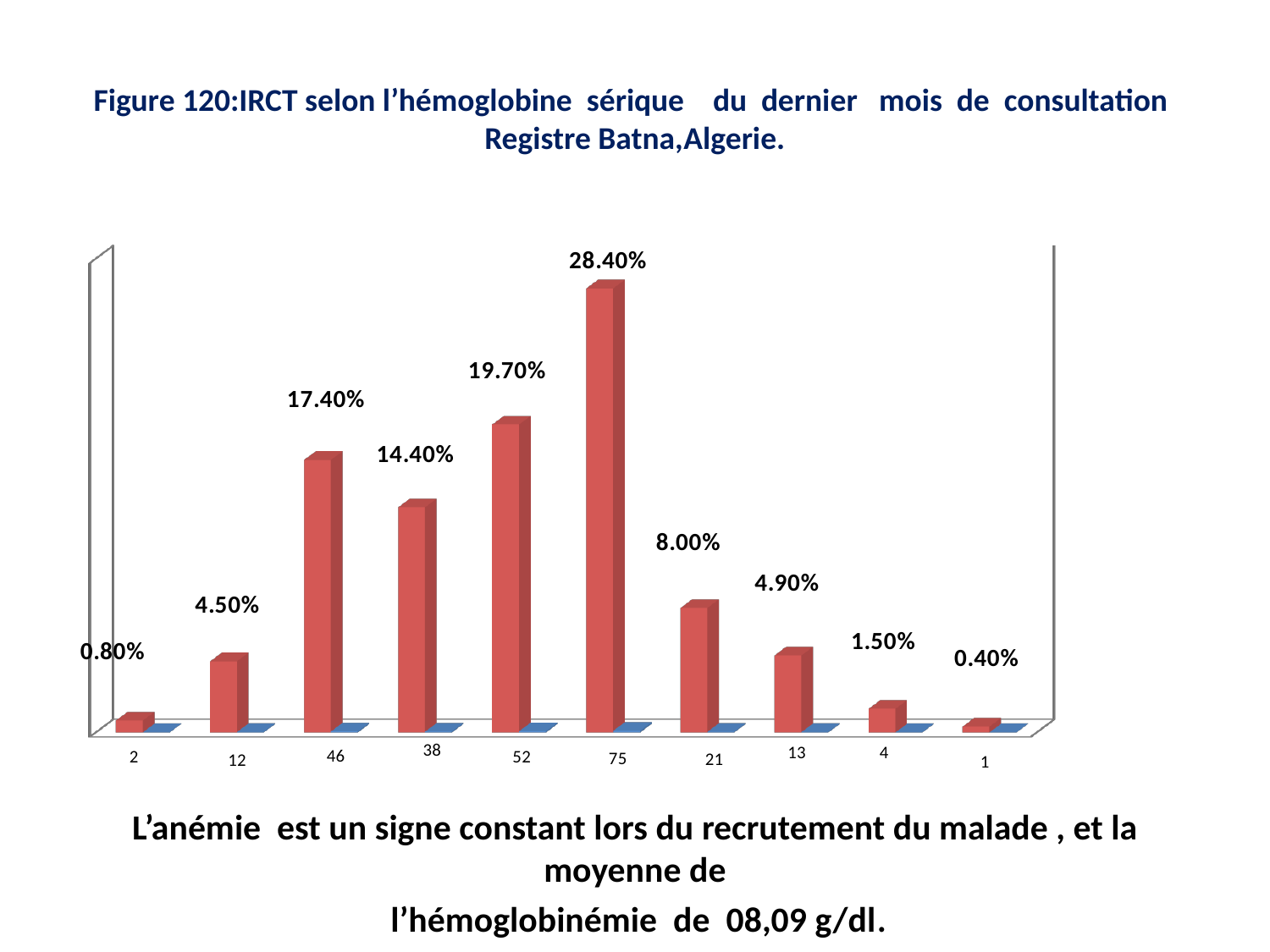
What is the value shown for the category labelled 46? 17.40% What is the difference between the values for the categories labelled 75 and 52? 8.70% What is the value shown for the category labelled 1? 0.40% Which is larger, the value for the category labelled 12 or the category labelled 13? 13 What is the figure number given in the chart title? Figure 120 What is the difference between the values for the categories labelled 46 and 38? 3.00% How many categories are shown on the x axis? 10 What kind of chart is shown on the slide? Bar chart Which category has the highest value? 75 What is the value shown for the category labelled 75? 28.40% What is the value shown for the category labelled 21? 8.00% Which category has the lowest value? 1